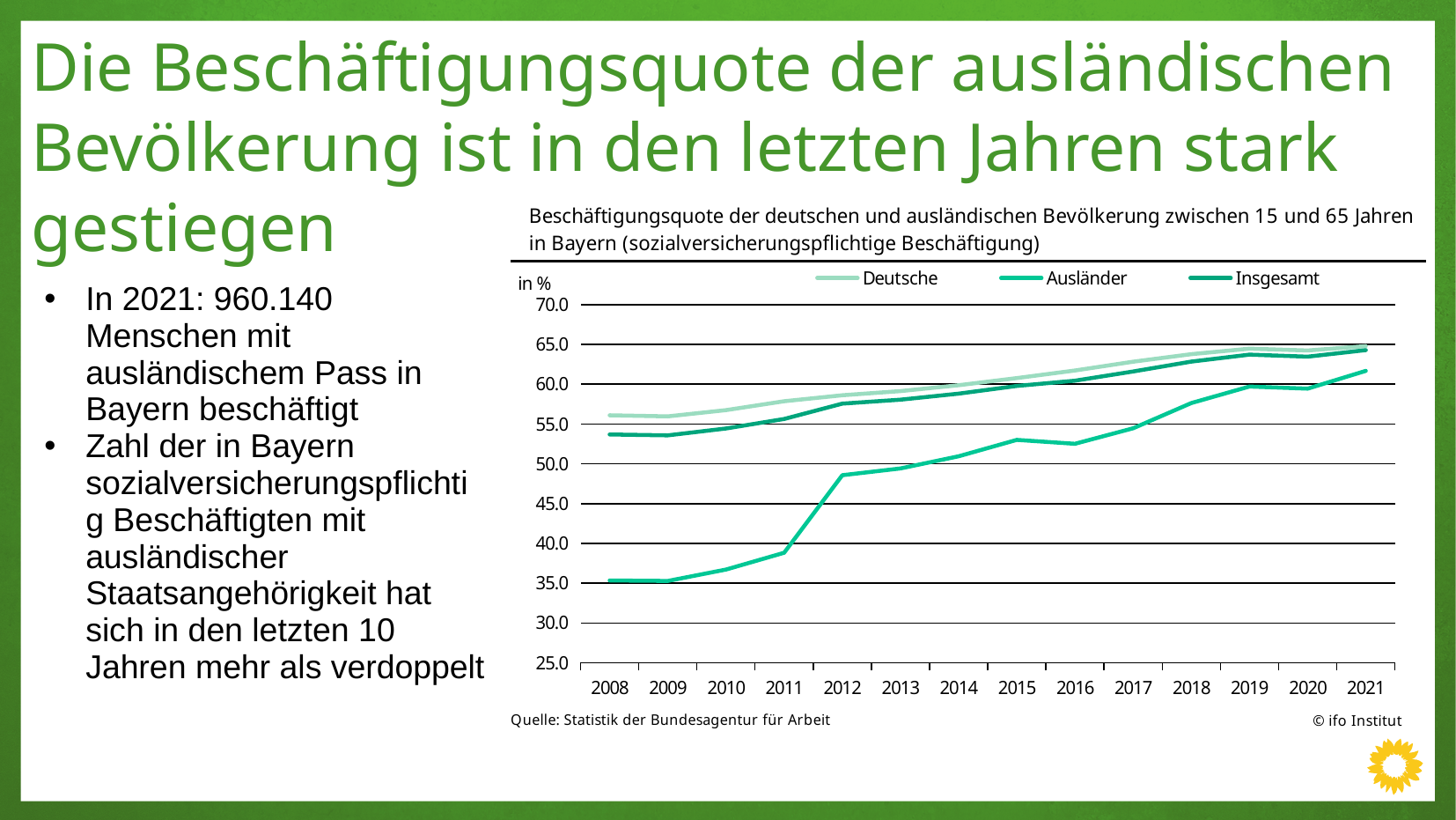
What kind of chart is shown on the slide? line chart Which series has the lowest value in 2008? Ausländer In 2012, which is larger: the value for Deutsche or the value for Ausländer? Deutsche Is the value for Insgesamt in 2008 greater or less than 55.0? less Which series has the highest value in 2012? Deutsche Is the value for Ausländer in 2021 greater or less than 60.0? greater What unit is shown on the y axis of the chart? in % How many years are shown on the x axis of the chart? 14 How many series does the chart legend list? 3 Is the value for Deutsche in 2008 greater or less than 55.0? greater Does the Ausländer series rise or fall from 2008 to 2021? rise